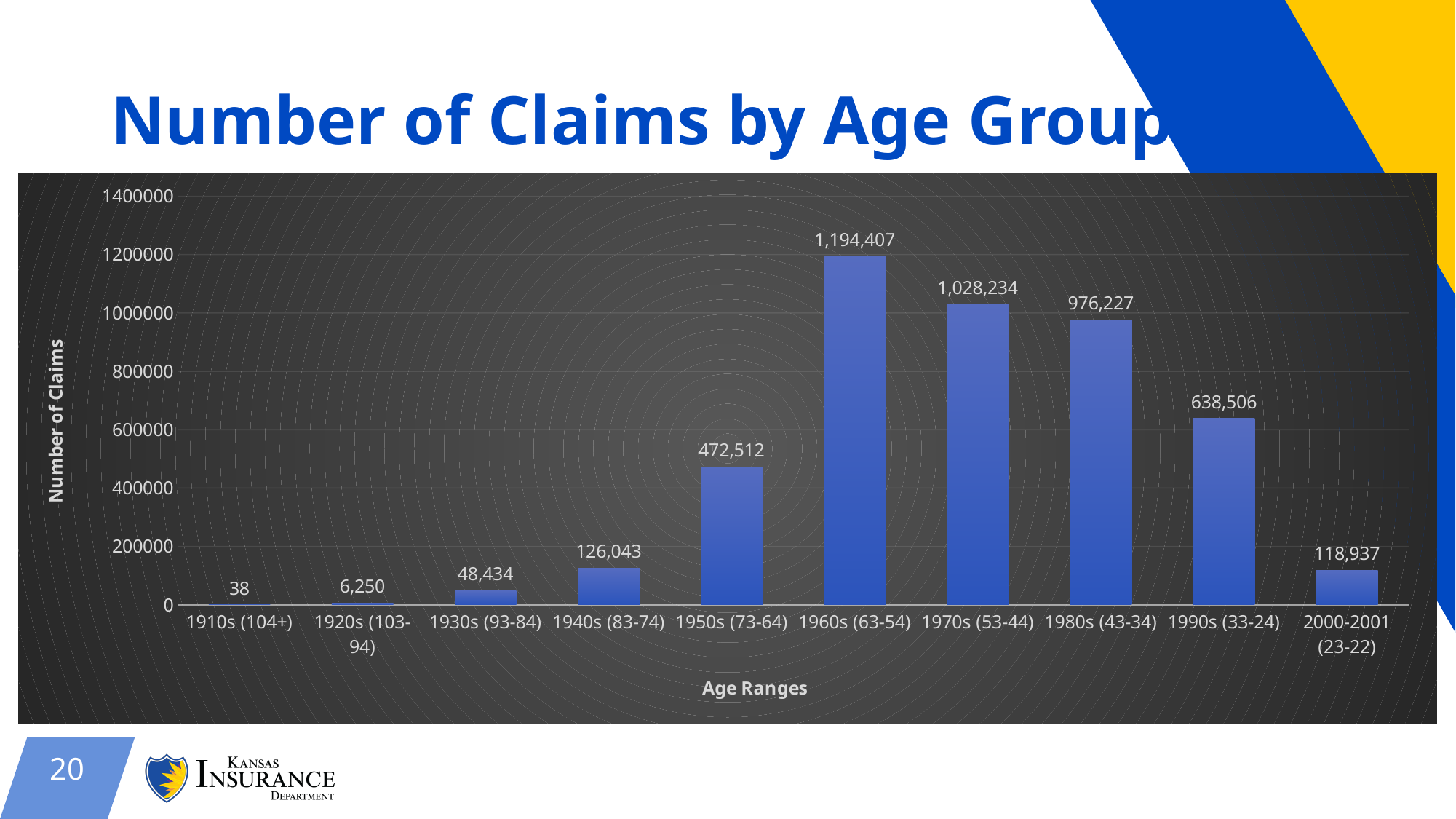
Do the number of claims rise or fall from the 1960s (63-54) group to the 2000-2001 (23-22) group? fall Which age group has the lowest number of claims? 1910s (104+) What is the number of claims for the 2000-2001 (23-22) age group? 118,937 Is the number of claims for the 1940s (83-74) age group greater or less than 200000? less How many age groups are shown on the chart? 10 Which age group has more claims, 1950s (73-64) or 1990s (33-24)? 1990s (33-24) Which age group has the highest number of claims? 1960s (63-54) What is the number of claims for the 1920s (103-94) age group? 6,250 What kind of chart is shown on the slide? bar chart What is the difference in claims between the 1970s (53-44) and 1980s (43-34) age groups? 52,007 What is the number of claims for the 1960s (63-54) age group? 1,194,407 What is the label of the x axis? Age Ranges